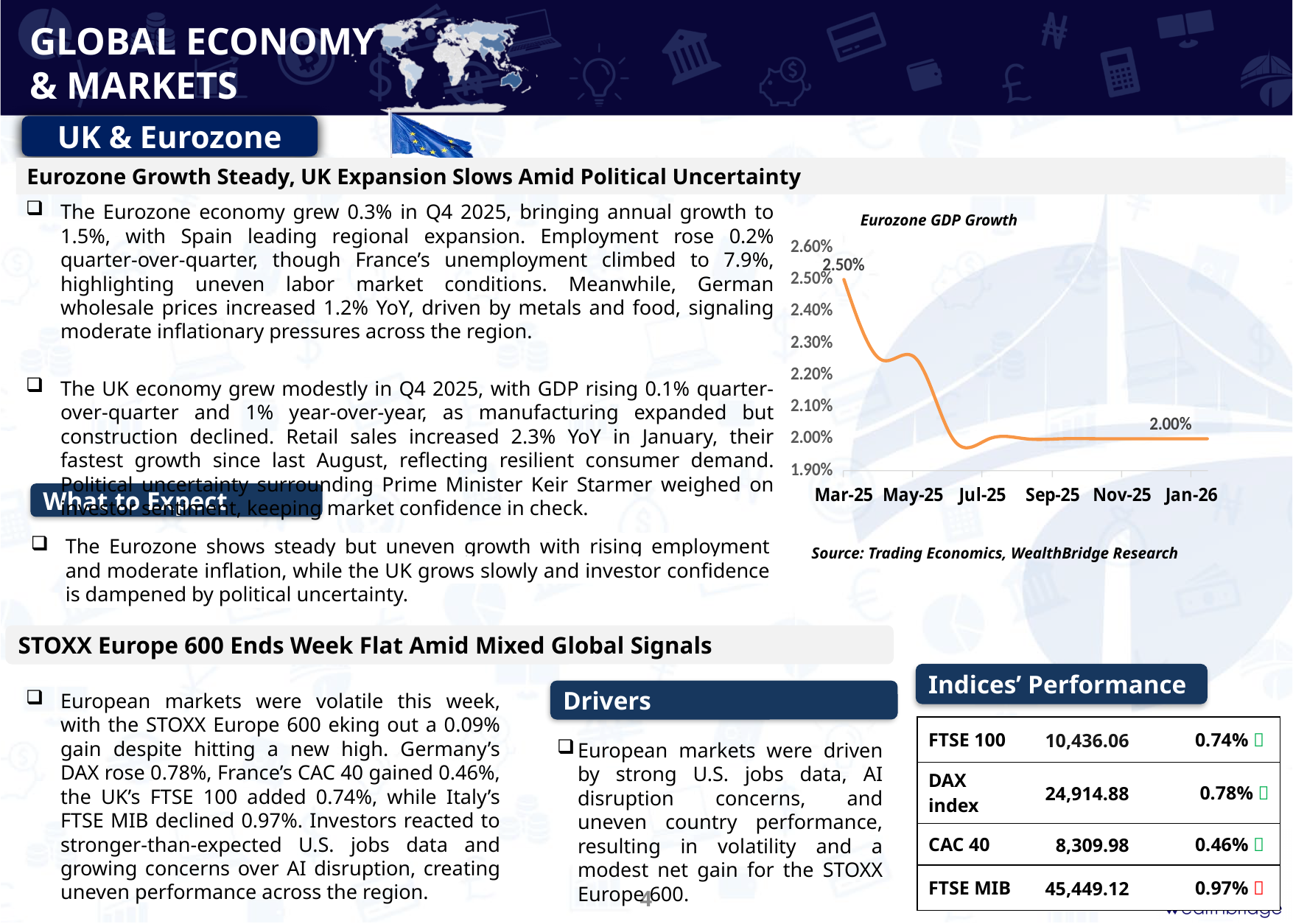
Is the Eurozone GDP growth value for Jul-25 greater or less than 2.10%? less Is the Eurozone GDP growth value for May-25 greater or less than 2.00%? greater How many month labels are shown on the x axis of the Eurozone GDP Growth chart? 6 At which month does the Eurozone GDP Growth line reach its highest point? Mar-25 What kind of chart is the Eurozone GDP Growth chart? line chart What source is cited below the Eurozone GDP Growth chart? Trading Economics, WealthBridge Research What is the Eurozone GDP growth value shown for Mar-25? 2.50% What is the Eurozone GDP growth value shown for Jan-26? 2.00% Does Eurozone GDP growth rise or fall from Mar-25 to Jan-26 on the chart? fall Which is larger on the Eurozone GDP Growth chart, the Mar-25 value or the Jan-26 value? Mar-25 What is the difference between the Mar-25 value and the Jan-26 value on the Eurozone GDP Growth chart? 0.50% What is the title of the chart on the slide? Eurozone GDP Growth